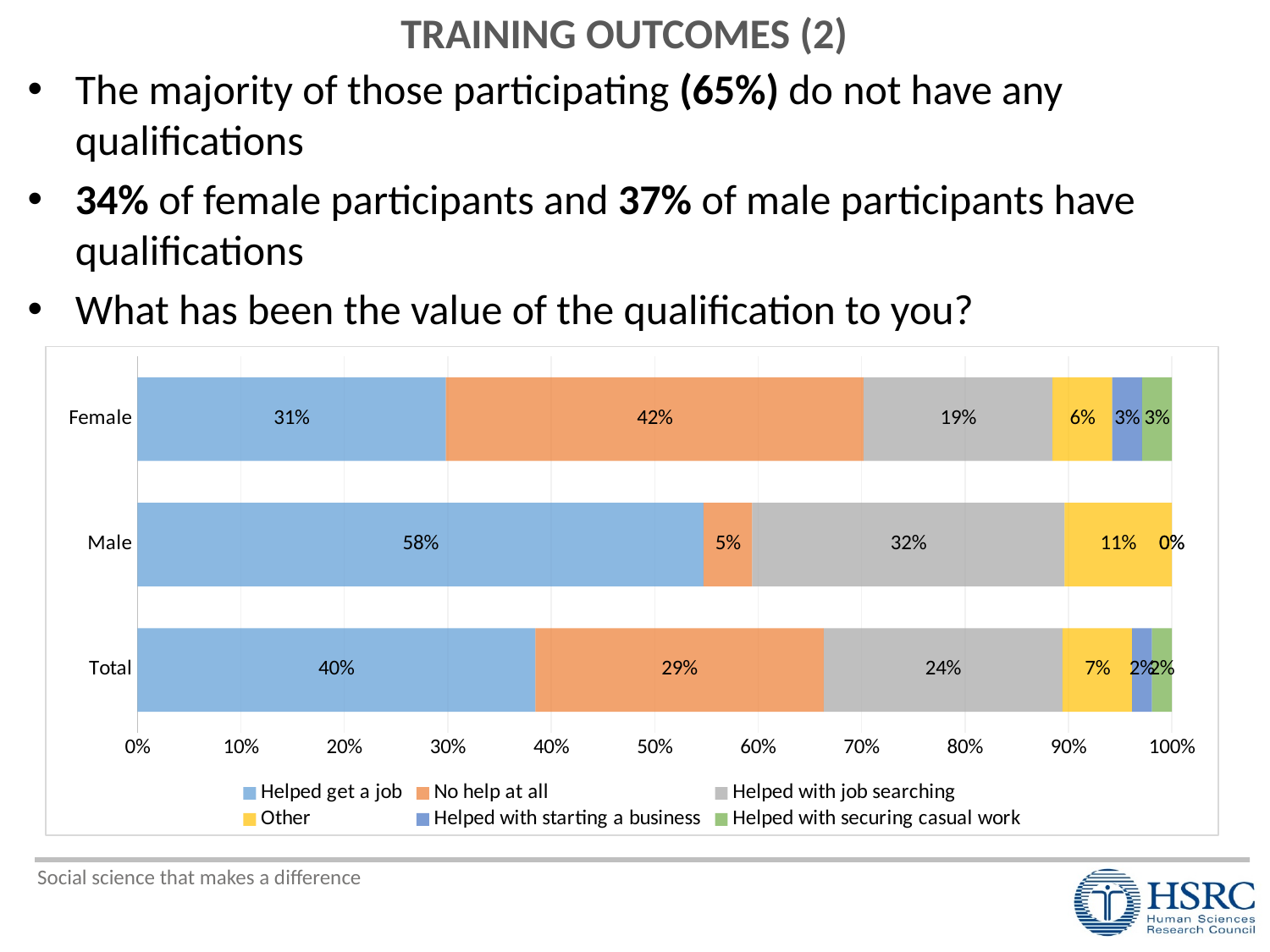
What kind of chart is shown on the slide? Stacked bar chart What is the value for 'No help at all' among female participants? 42% How many groups (bars) are shown in the chart? 3 What is the difference between the male and female values for 'Helped get a job'? 27 percentage points Which group has the lowest value for 'No help at all'? Male What is the value for 'Other' in the Total bar? 7% Which group has the highest value for 'Helped get a job'? Male What is the value for 'Helped with job searching' among male participants? 32% What percentage of female participants said the qualification helped get a job? 31% What percentage of male participants said the qualification helped get a job? 58% Which is larger: the 'No help at all' value for Female or for Total? Female How many series does the legend list? 6